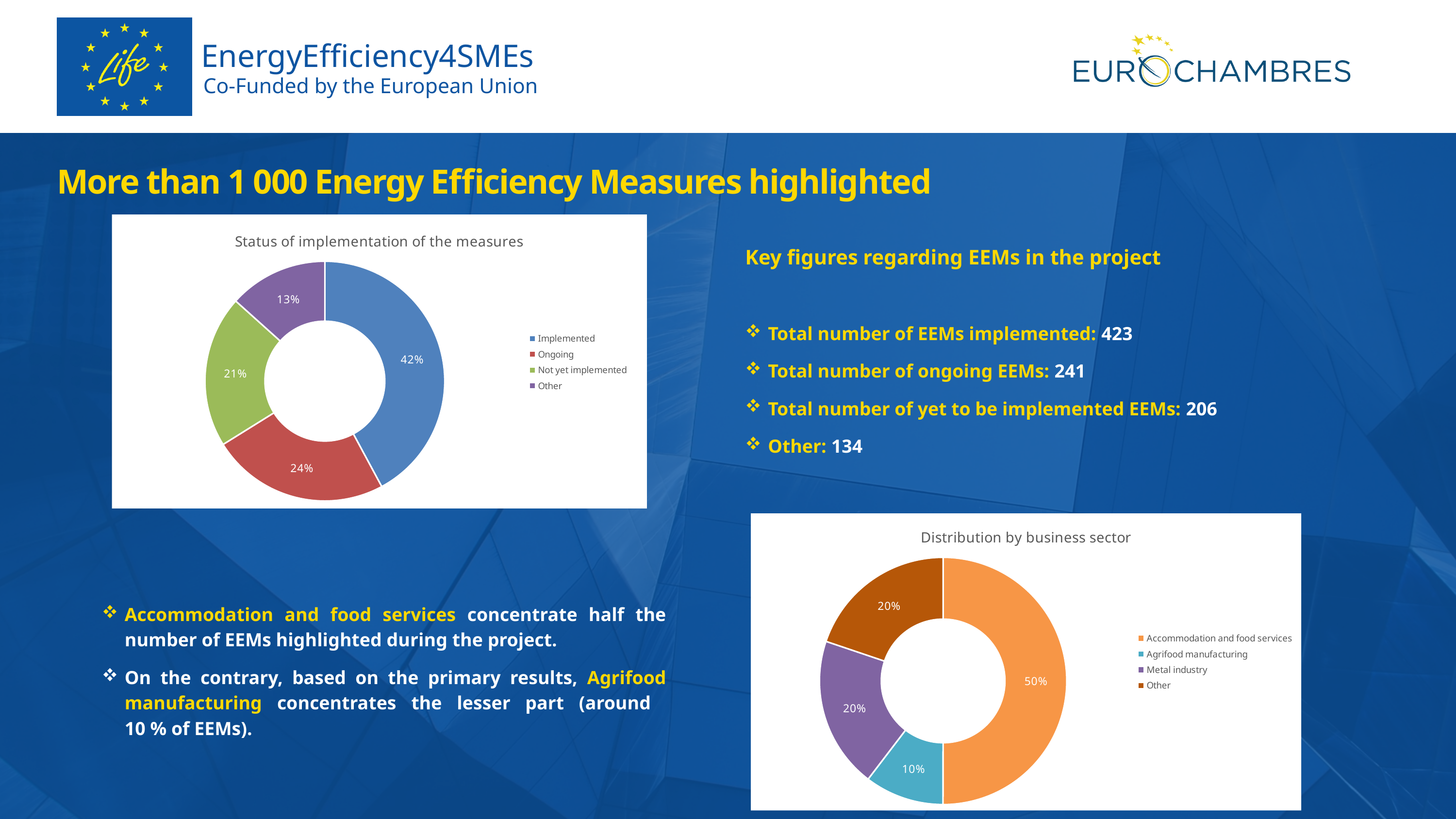
What kind of chart is 'Status of implementation of the measures'? Doughnut (pie) chart In the 'Status of implementation of the measures' chart, what is the difference in percentage points between Implemented and Ongoing? 18 In the 'Distribution by business sector' chart, which sector has the smallest share? Agrifood manufacturing In the 'Status of implementation of the measures' chart, how many categories does the legend list? 4 In the 'Distribution by business sector' chart, what share is labelled for Accommodation and food services? 50% In the 'Status of implementation of the measures' chart, what share is labelled for Implemented? 42% In the 'Distribution by business sector' chart, is the share for Metal industry larger or smaller than the share for Agrifood manufacturing? larger In the 'Status of implementation of the measures' chart, what share is labelled for Not yet implemented? 21% In the 'Status of implementation of the measures' chart, which category has the smallest share? Other In the 'Distribution by business sector' chart, what share is labelled for Agrifood manufacturing? 10% In the 'Distribution by business sector' chart, what colour is the Accommodation and food services slice? Orange In the 'Status of implementation of the measures' chart, which category has the largest share? Implemented